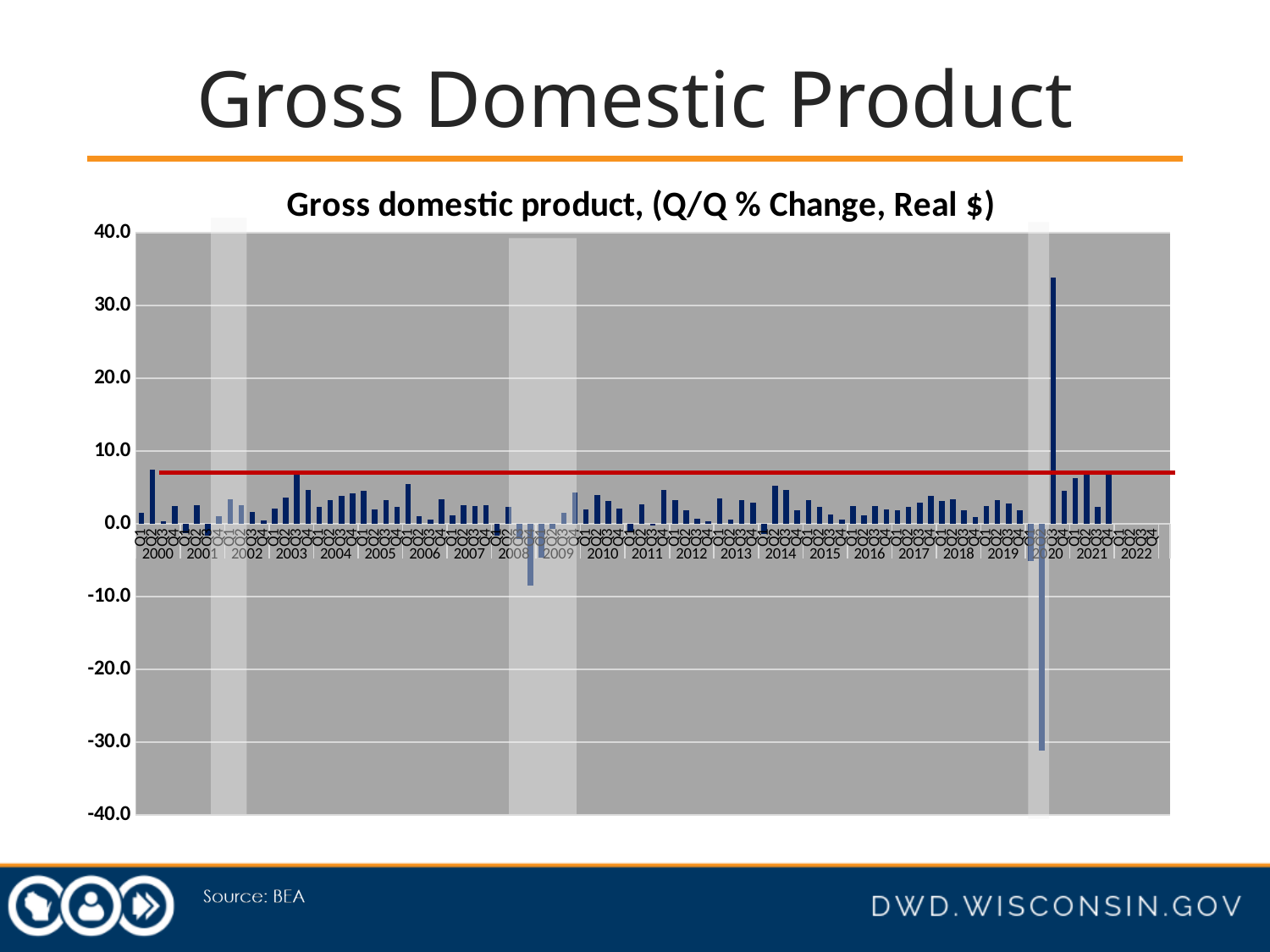
Which quarter has the highest value on the chart? 2020 Q3 Is the value for 2020 Q2 greater or less than -20.0? less What kind of chart is shown on the slide? bar chart What source is cited for the chart data? BEA Is the value for 2008 Q4 greater or less than -10.0? greater Which is larger, the value for 2020 Q2 or the value for 2008 Q4? 2008 Q4 How many years are labelled along the x axis of the chart? 23 Is the value for 2020 Q3 greater or less than 40.0? less What is the title of the chart? Gross domestic product, (Q/Q % Change, Real $) Which quarter has the lowest value on the chart? 2020 Q2 Which is larger, the value for 2020 Q3 or the value for 2021 Q1? 2020 Q3